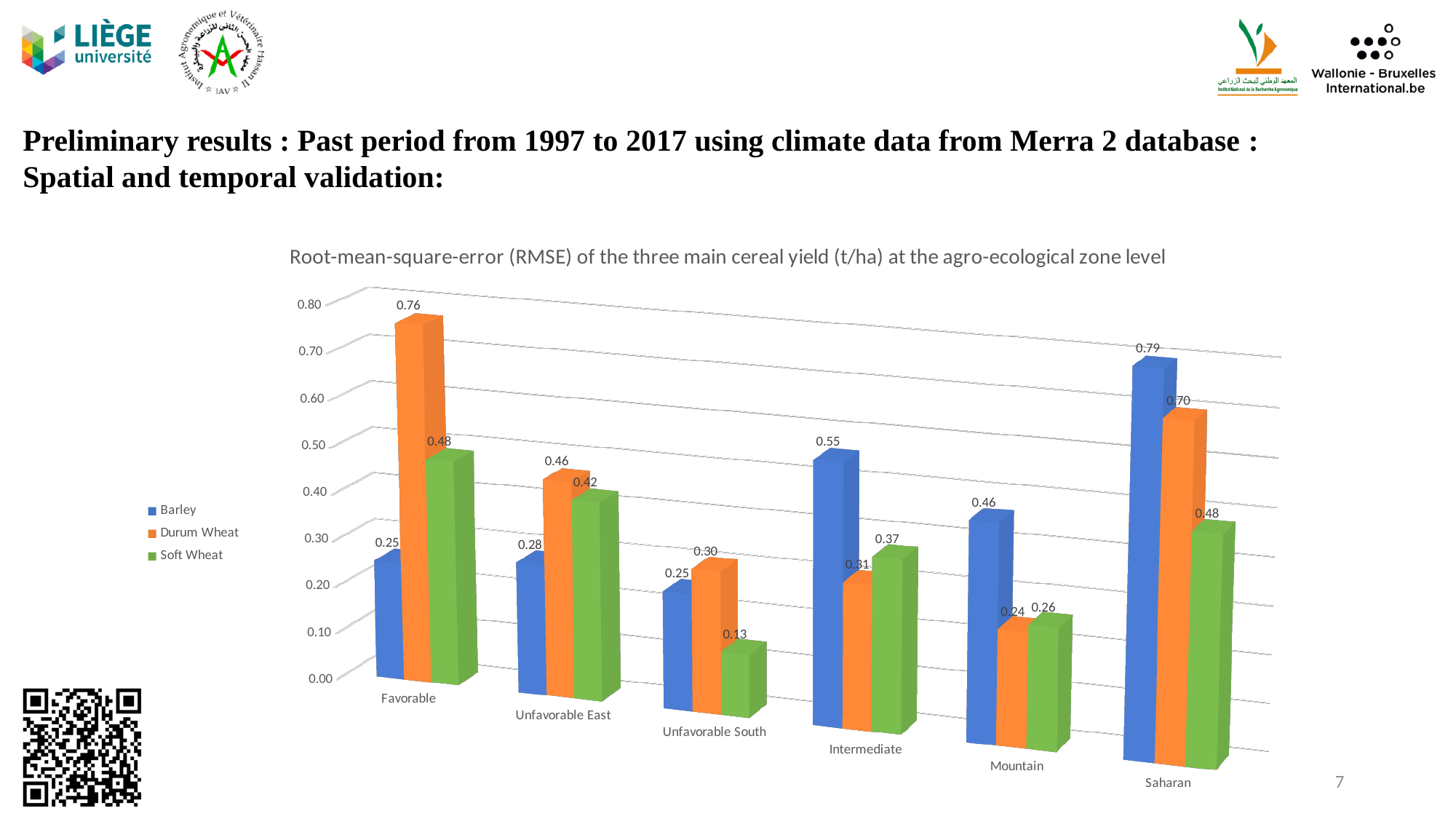
Which agro-ecological zone has the lowest Soft Wheat RMSE? Unfavorable South What kind of chart is shown on the slide? Bar chart What is the RMSE value for Soft Wheat in the Unfavorable South zone? 0.13 What is the RMSE value for Barley in the Saharan zone? 0.79 Which colour represents Soft Wheat in the chart? Green What is the RMSE value for Durum Wheat in the Mountain zone? 0.24 How many agro-ecological zones are shown on the x axis? 6 What is the RMSE value for Durum Wheat in the Favorable zone? 0.76 In the Intermediate zone, which has the larger RMSE, Barley or Soft Wheat? Barley Which agro-ecological zone has the highest Barley RMSE? Saharan How many series does the legend list? 3 What is the difference between the Durum Wheat RMSE and the Barley RMSE in the Favorable zone? 0.51